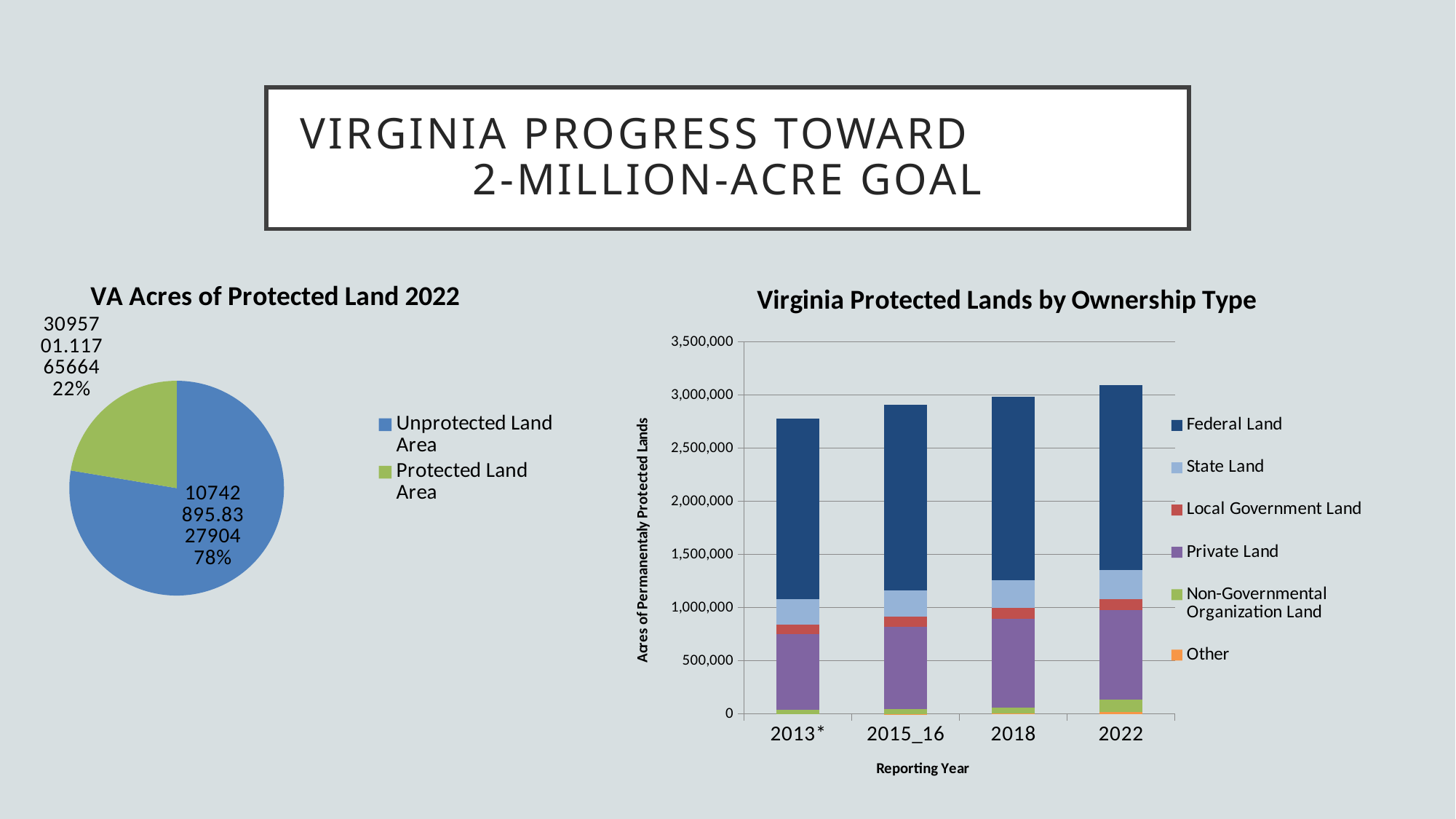
In 'Virginia Protected Lands by Ownership Type', do the total protected acres rise or fall from 2013* to 2022? rise What type of chart is 'Virginia Protected Lands by Ownership Type'? Stacked bar chart What is the y-axis label of the chart 'Virginia Protected Lands by Ownership Type'? Acres of Permanentaly Protected Lands In 'Virginia Protected Lands by Ownership Type', which reporting year has the shortest stacked bar? 2013* In 'Virginia Protected Lands by Ownership Type', is the total stacked bar for 2022 greater or less than 3,000,000? greater In the pie chart 'VA Acres of Protected Land 2022', what share of the pie is Protected Land Area? 22% How many reporting years are shown on the x axis of 'Virginia Protected Lands by Ownership Type'? 4 In the pie chart 'VA Acres of Protected Land 2022', what share of the pie is Unprotected Land Area? 78% How many series does the legend of 'Virginia Protected Lands by Ownership Type' list? 6 In 'Virginia Protected Lands by Ownership Type', which reporting year has the tallest stacked bar? 2022 How many slices does the pie chart 'VA Acres of Protected Land 2022' have? 2 In the pie chart 'VA Acres of Protected Land 2022', which slice is larger, Unprotected Land Area or Protected Land Area? Unprotected Land Area